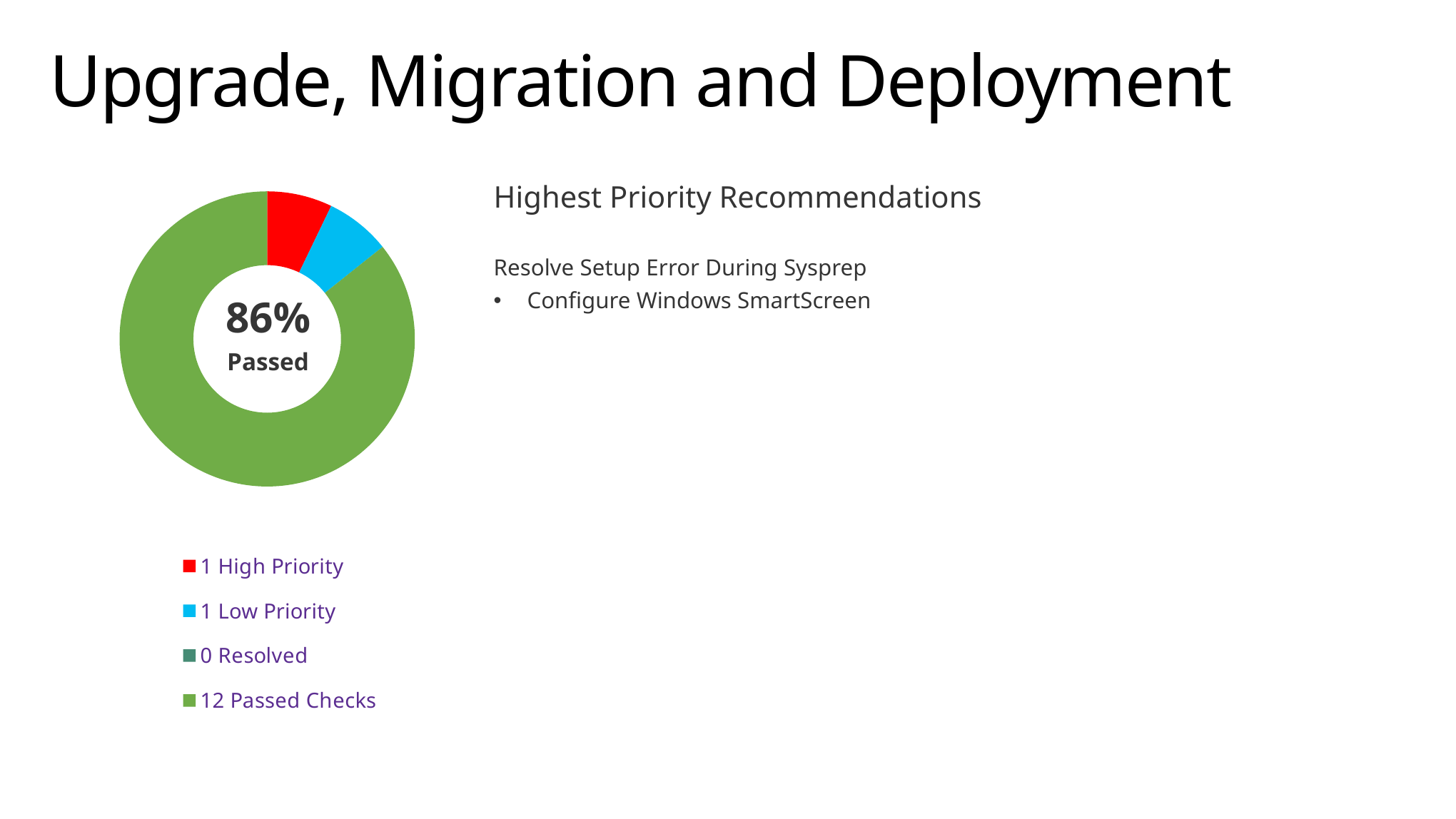
What percentage is shown as Passed in the centre of the chart? 86% What kind of chart is shown on the slide? Doughnut (pie) chart How many Low Priority items does the legend show? 1 How many Resolved items does the legend show? 0 Which category has the largest value in the chart? Passed Checks Which category has the smallest value in the chart? Resolved How many Passed Checks does the legend show? 12 How many categories does the chart legend list? 4 What colour represents High Priority in the chart? Red What is the difference between the number of Passed Checks and the number of High Priority items? 11 How many High Priority items does the legend show? 1 Which is larger, the number of Passed Checks or the number of Low Priority items? Passed Checks